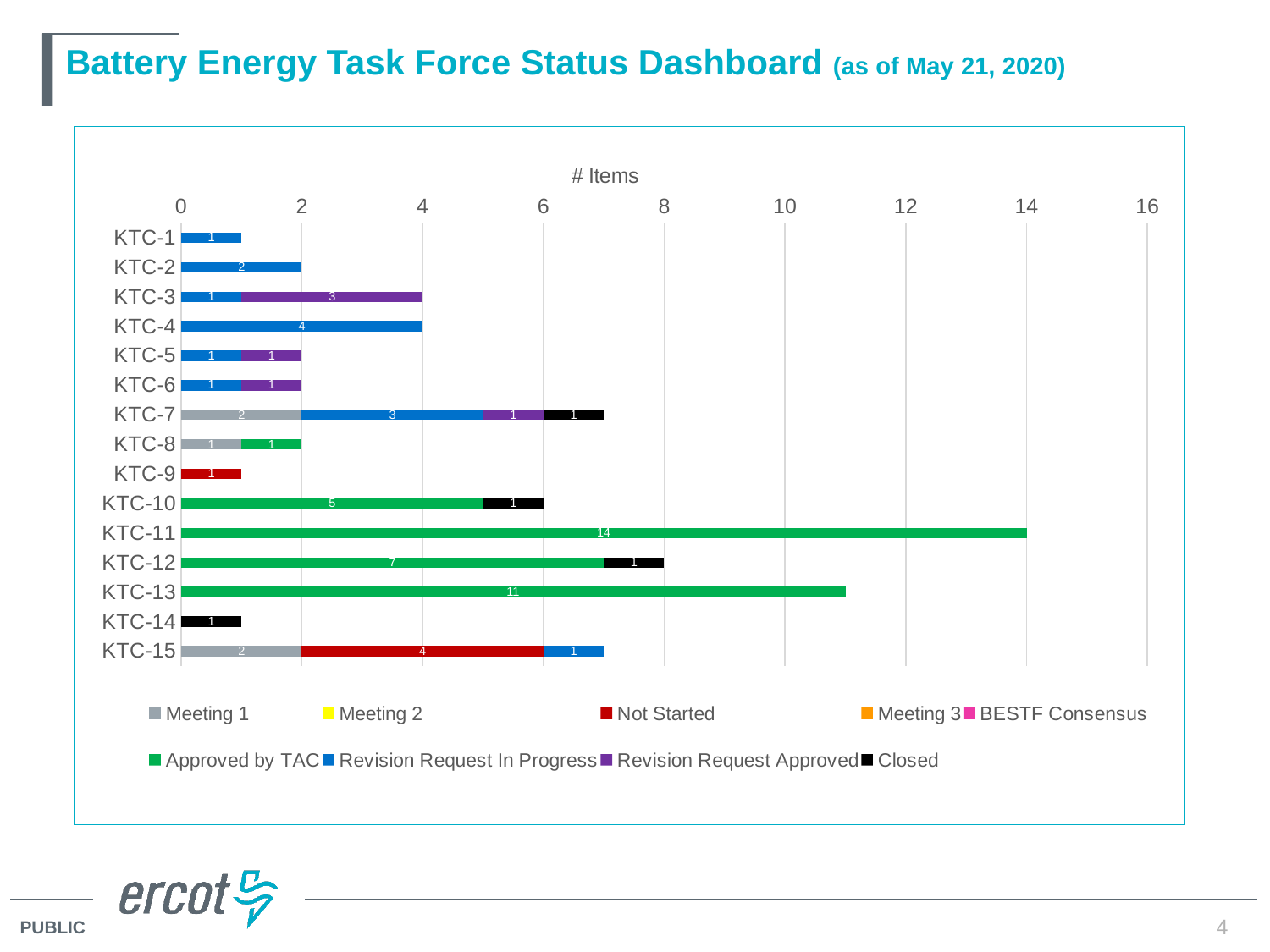
What is the Revision Request Approved value for KTC-3? 3 How many series does the legend list? 9 What is the Not Started value for KTC-15? 4 Which has a larger Revision Request In Progress value, KTC-4 or KTC-2? KTC-4 What kind of chart is shown on the slide? Stacked bar chart Which KTC has the longest total bar? KTC-11 What is the title of the chart? # Items What is the Approved by TAC value for KTC-11? 14 What is the total number of items for KTC-7? 7 What is the difference between the Approved by TAC values for KTC-11 and KTC-13? 3 What is the total number of items for KTC-12? 8 How many KTC categories are plotted on the chart? 15